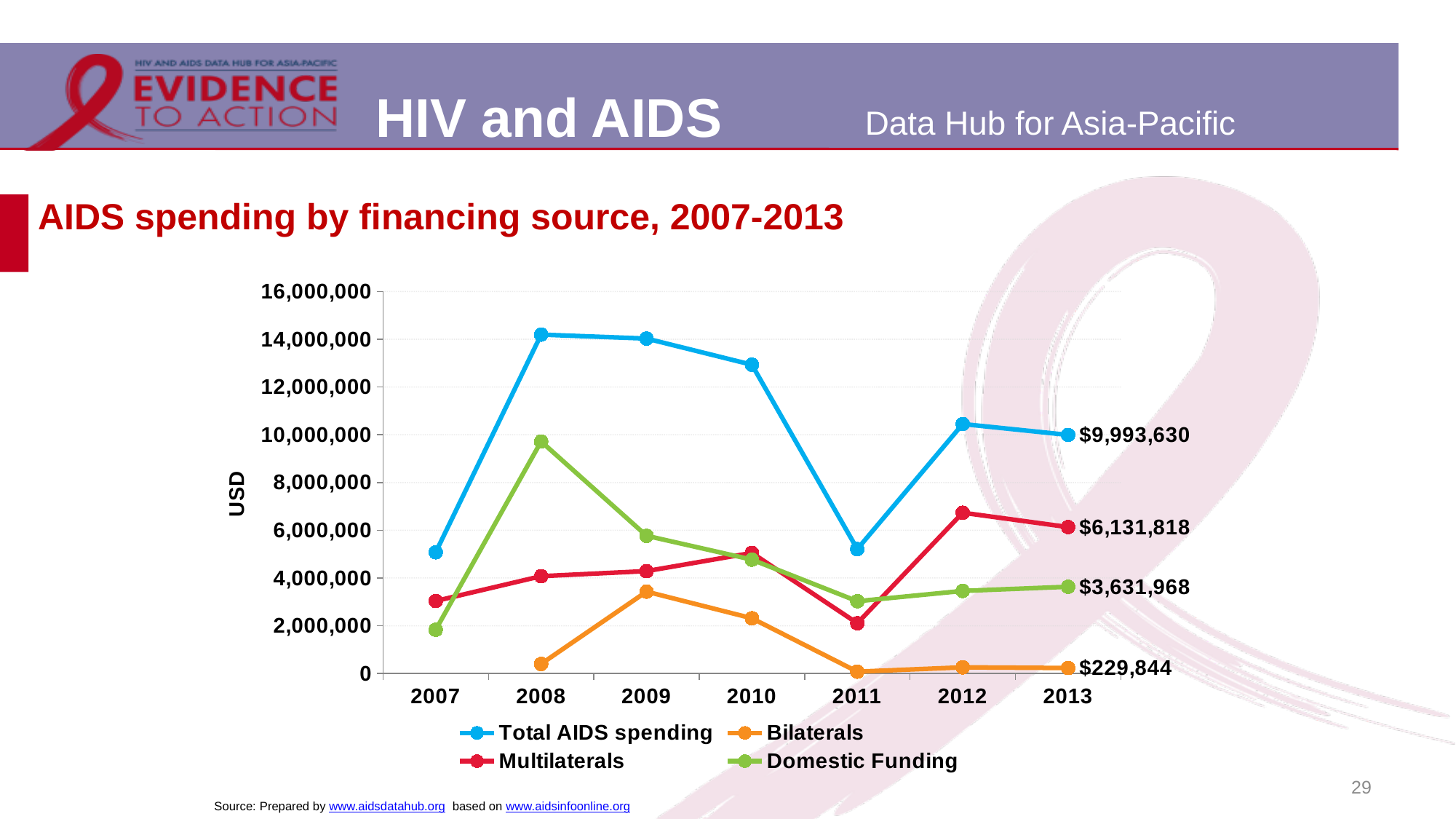
What is the difference between Multilaterals and Domestic Funding in 2013? $2,499,850 What is the value of Total AIDS spending in 2013? $9,993,630 What is the value of Multilaterals in 2013? $6,131,818 What kind of chart is shown on the slide? Line chart In which year is Domestic Funding highest? 2008 Is the value for Total AIDS spending in 2010 greater or less than 12,000,000? greater What is the value of Domestic Funding in 2013? $3,631,968 How many years are shown on the x axis? 7 How many series does the legend list? 4 Does Total AIDS spending rise or fall from 2008 to 2011? Falls What is the value of Bilaterals in 2013? $229,844 In which year is Multilaterals lowest? 2011